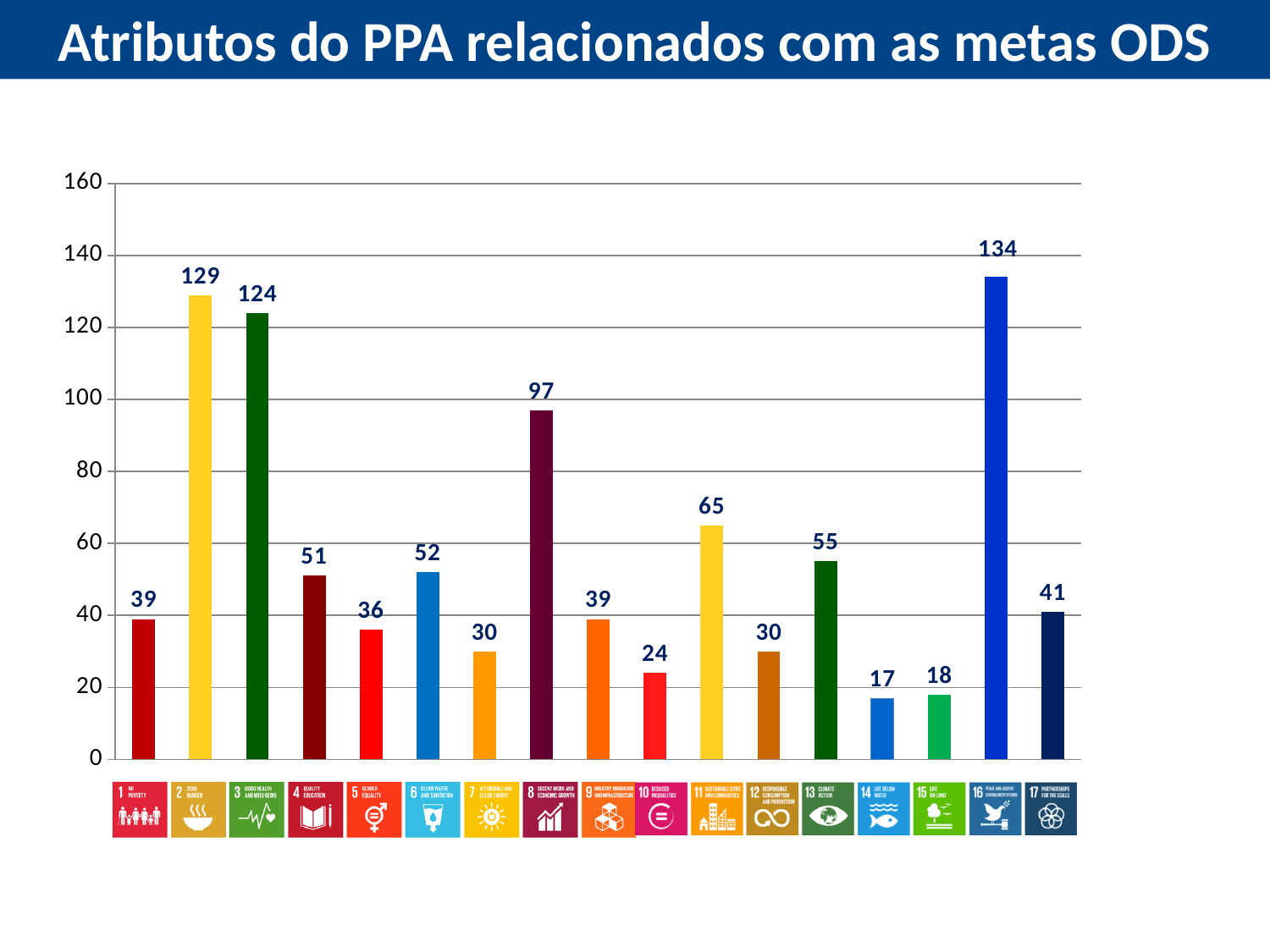
What is the value for SDG 16 (Peace, Justice and Strong Institutions)? 134 What is the value for SDG 10 (Reduced Inequalities)? 24 How many bars (SDG categories) are plotted in the chart? 17 What is the value for SDG 2 (Zero Hunger)? 129 Which SDG has the highest value in the chart? SDG 16 What is the value for SDG 8 (Decent Work and Economic Growth)? 97 What type of chart is shown on the slide? bar chart Which SDG has the lowest value in the chart? SDG 14 Which has a larger value, SDG 3 or SDG 8? SDG 3 What is the difference between the values for SDG 16 and SDG 2? 5 What is the difference between the values for SDG 11 and SDG 13? 10 What is the title of the chart on the slide? Atributos do PPA relacionados com as metas ODS